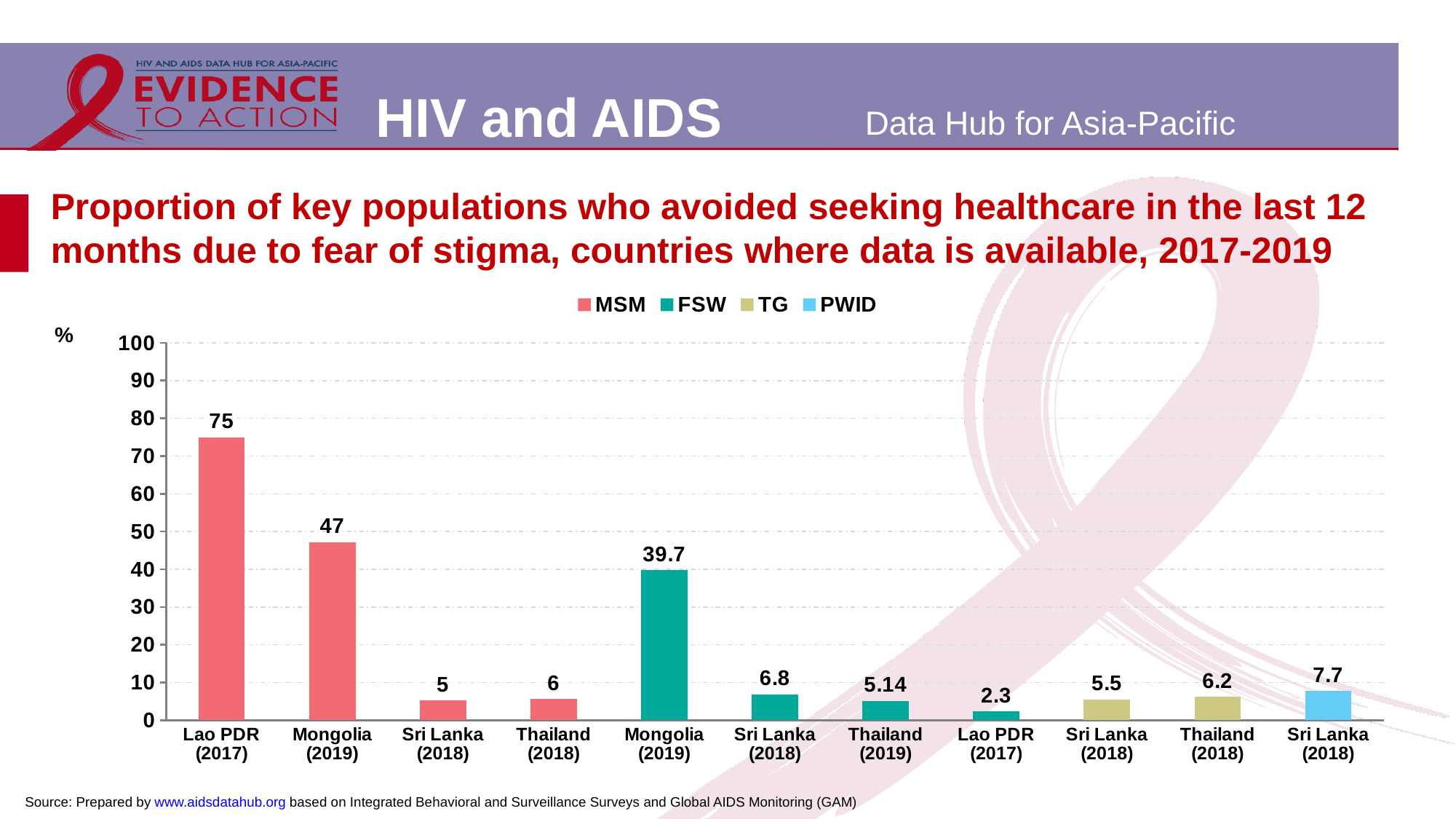
What kind of chart is shown on the slide? Bar chart Which is larger: the TG value for Thailand (2018) or the TG value for Sri Lanka (2018)? Thailand (2018) What is the value for FSW in Thailand (2019)? 5.14 How many series does the legend list? 4 Which bar has the highest value on the chart? MSM, Lao PDR (2017) What is the value for MSM in Lao PDR (2017)? 75 What is the value for PWID in Sri Lanka (2018)? 7.7 Which bar has the lowest value on the chart? FSW, Lao PDR (2017) What is the difference between the MSM values for Lao PDR (2017) and Mongolia (2019)? 28 What is the difference between the FSW values for Sri Lanka (2018) and Lao PDR (2017)? 4.5 How many bars are plotted on the chart? 11 What is the value for FSW in Mongolia (2019)? 39.7